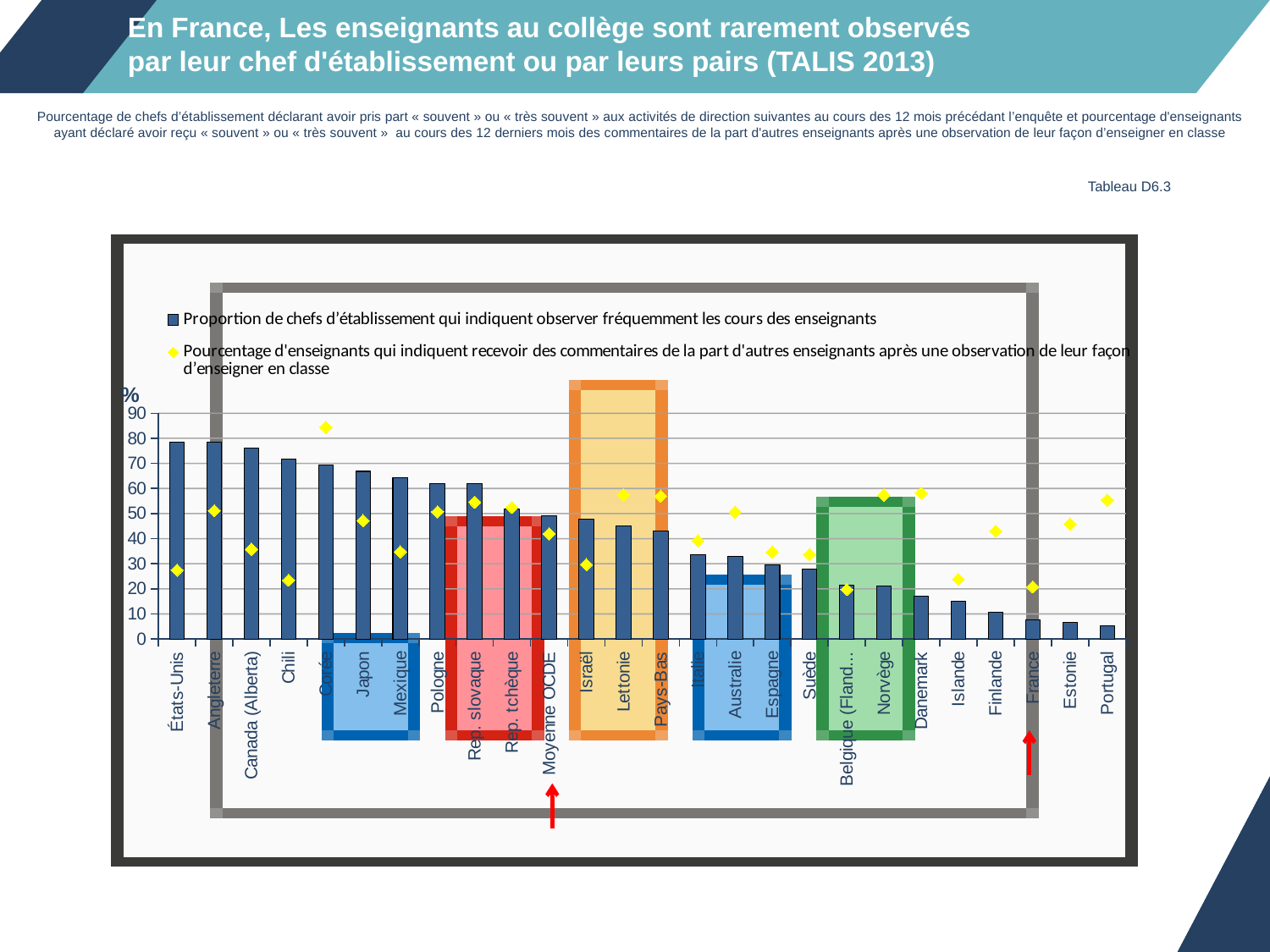
Is the bar value for Portugal greater or less than 10? less Which is larger, the bar for Japon or the bar for Islande? Japon How many countries or categories are shown along the x axis? 26 How many series does the legend list? 2 Is the bar value for France greater or less than 10? less What unit is shown at the top of the y axis? % Is the bar value for États-Unis greater or less than 70? greater Do the bar values generally rise or fall from left to right along the x axis? fall What kind of chart is shown on the slide? combination bar and line chart (bars with diamond markers) Which category has the highest diamond marker value (percentage of teachers receiving feedback after observation)? Corée